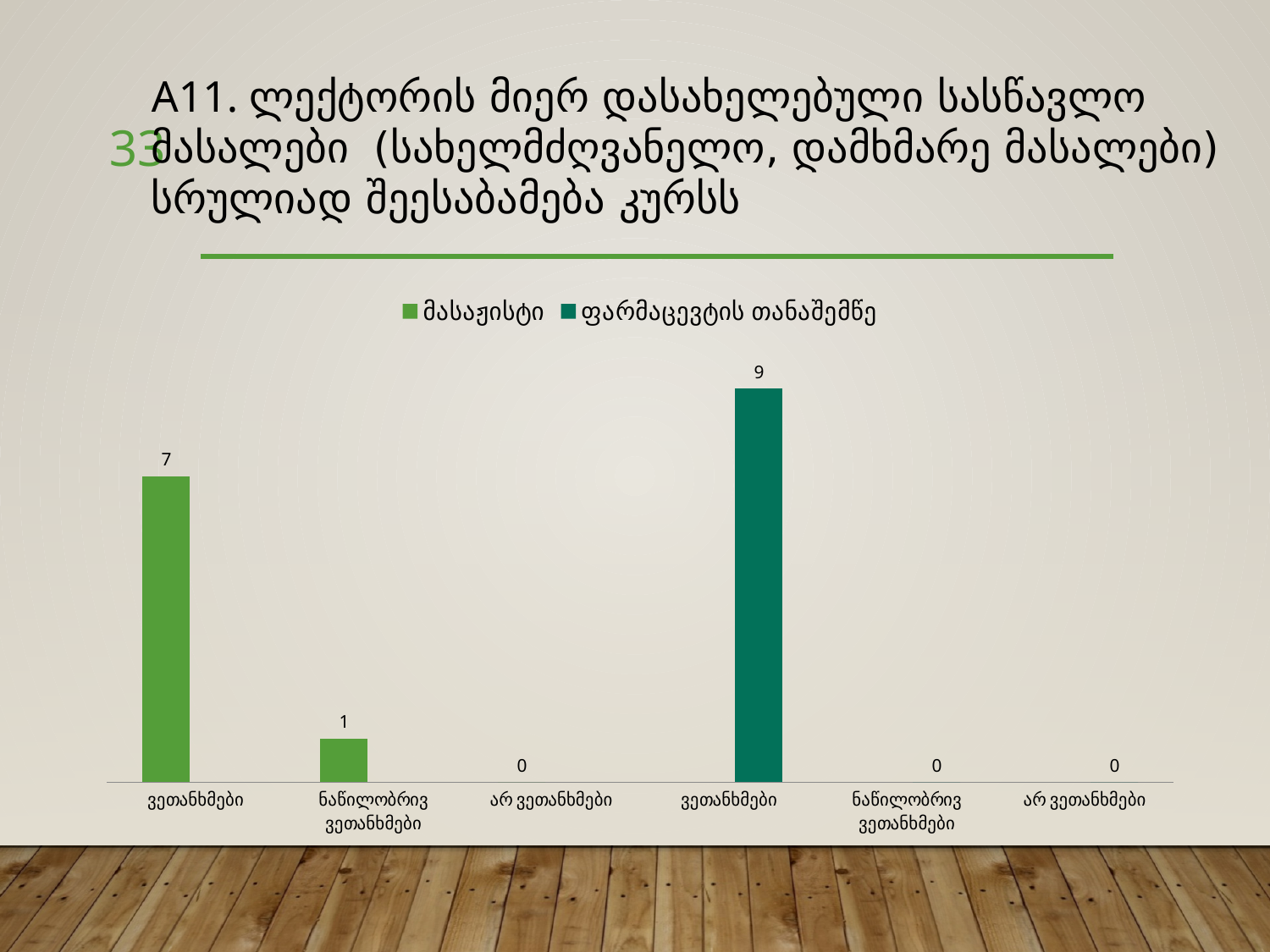
What is the difference between ვეთანხმები and ნაწილობრივ ვეთანხმები in the მასაჟისტი series? 6 Which bar has the highest value on the chart? ვეთანხმები (ფარმაცევტის თანაშემწე) How many series does the legend list? 2 What kind of chart is shown on the slide? bar chart How many bars are labelled with the value 0 on the chart? 3 What is the value for ვეთანხმები in the ფარმაცევტის თანაშემწე series? 9 What is the value for ნაწილობრივ ვეთანხმები in the მასაჟისტი series? 1 Which is larger: the ვეთანხმები value for მასაჟისტი or for ფარმაცევტის თანაშემწე? ფარმაცევტის თანაშემწე What is the value for არ ვეთანხმები in the ფარმაცევტის თანაშემწე series? 0 What is the difference between the ვეთანხმები values of the ფარმაცევტის თანაშემწე and მასაჟისტი series? 2 Which legend entry is shown in the darker green colour? ფარმაცევტის თანაშემწე What is the value for ვეთანხმები in the მასაჟისტი series? 7